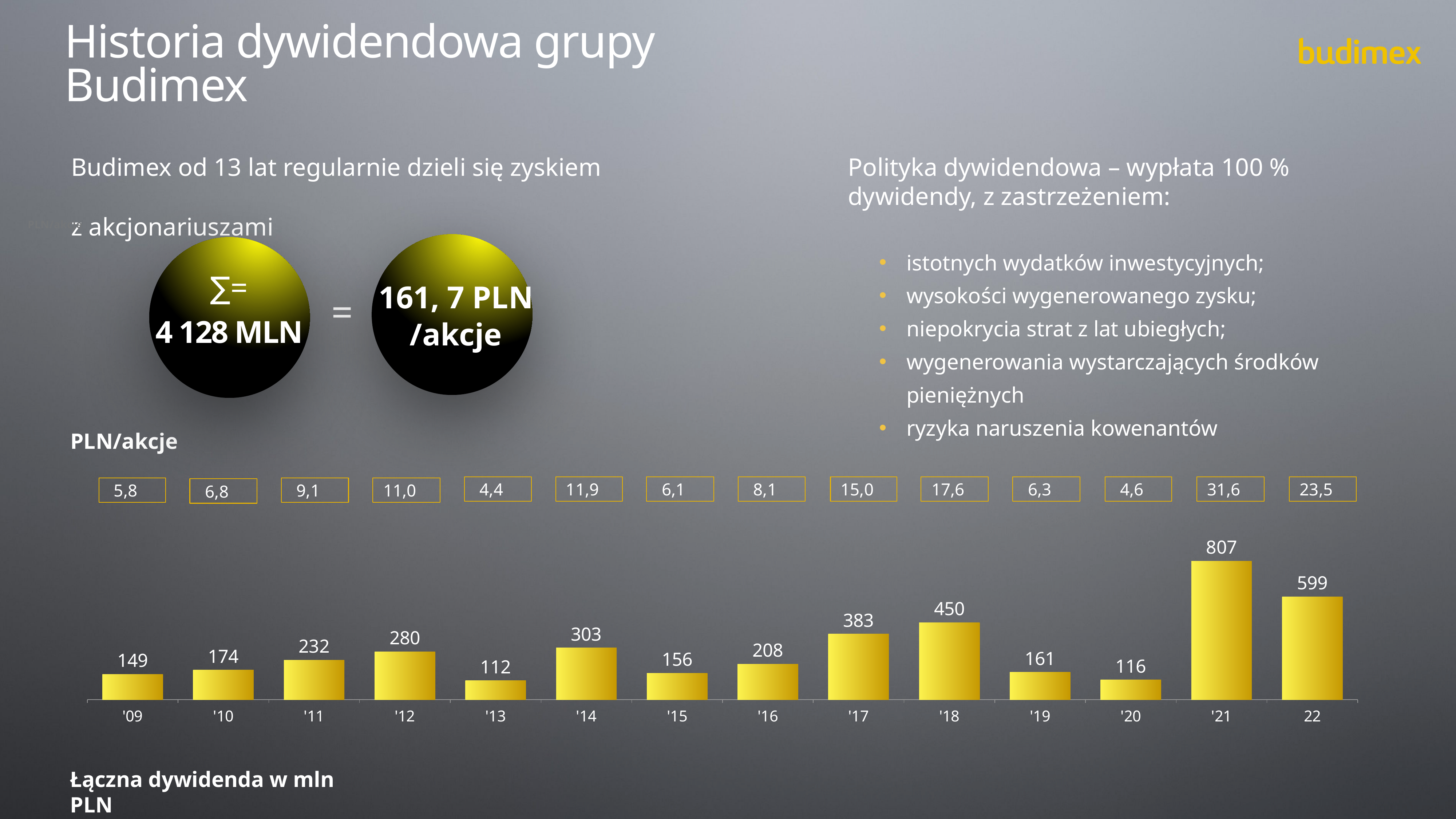
Which year has the highest total dividend in the bar chart? '21 What is the total dividend (in mln PLN) shown for '21? 807 What kind of chart is used to show the total dividend in mln PLN? bar chart Which year has the lowest total dividend in the bar chart? '13 How many years (bars) are shown in the bar chart? 14 What is the difference between the total dividend for '21 and for 22? 208 What is the total dividend (in mln PLN) shown for '14? 303 Which year has the larger total dividend, '17 or '18? '18 What is the label below the bar chart describing the plotted values? Łączna dywidenda w mln PLN What is the PLN/akcje value shown for '13? 4,4 Do the total dividend values rise or fall from '19 to '20? fall What is the PLN/akcje value shown for '21? 31,6